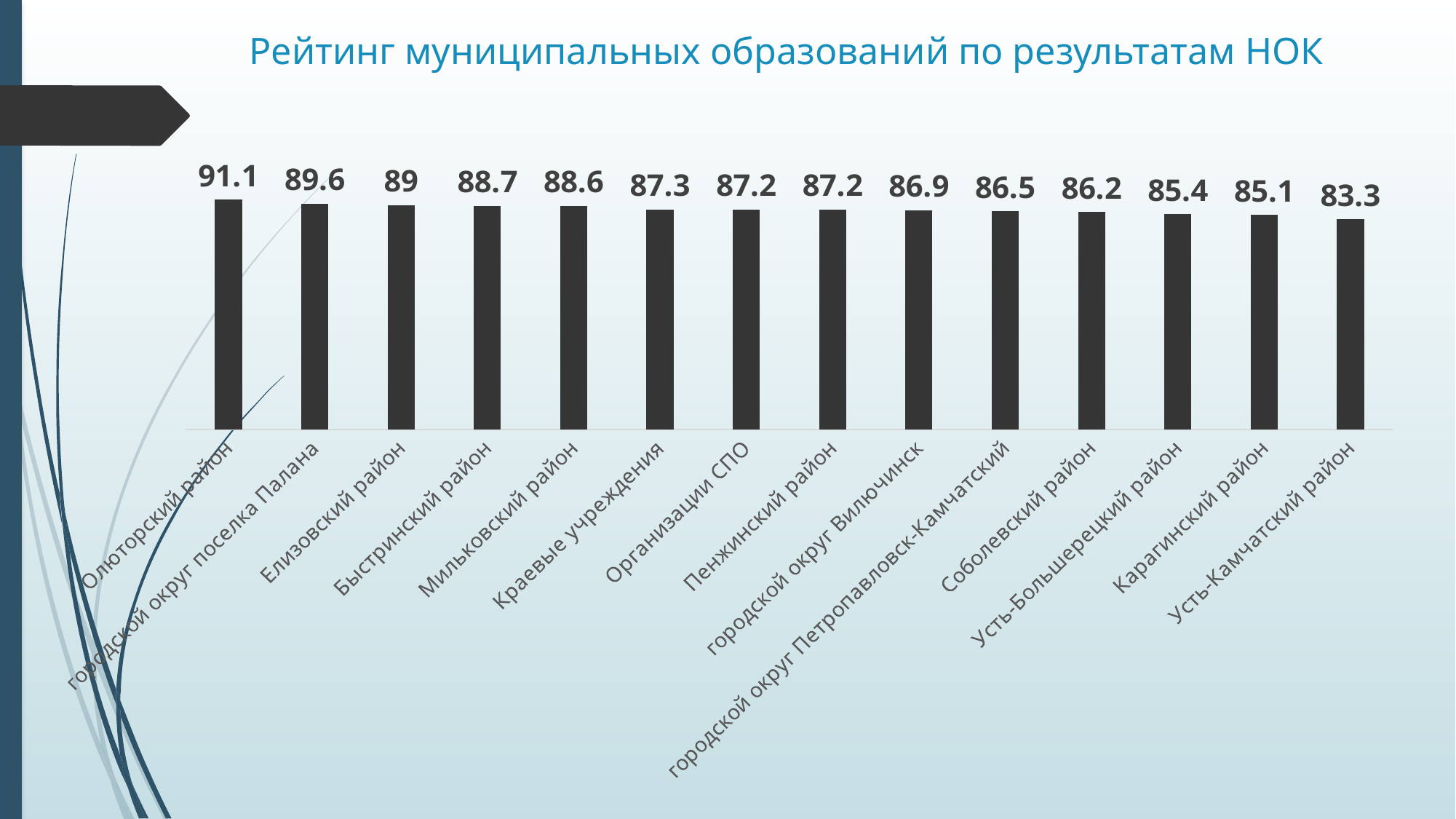
What is the difference between the values for Олюторский район and Усть-Камчатский район? 7.8 What is the value for Усть-Большерецкий район? 85.4 Which is larger, the value for Быстринский район or the value for Карагинский район? Быстринский район What is the difference between the values for городской округ поселка Палана and Соболевский район? 3.4 What is the value for Олюторский район? 91.1 What kind of chart is shown on the slide? Bar chart Do the values rise or fall from left to right along the x axis? Fall What is the value for городской округ Вилючинск? 86.9 Which category has the highest value? Олюторский район How many categories are shown in the chart? 14 What is the value for Елизовский район? 89 Which category has the lowest value? Усть-Камчатский район